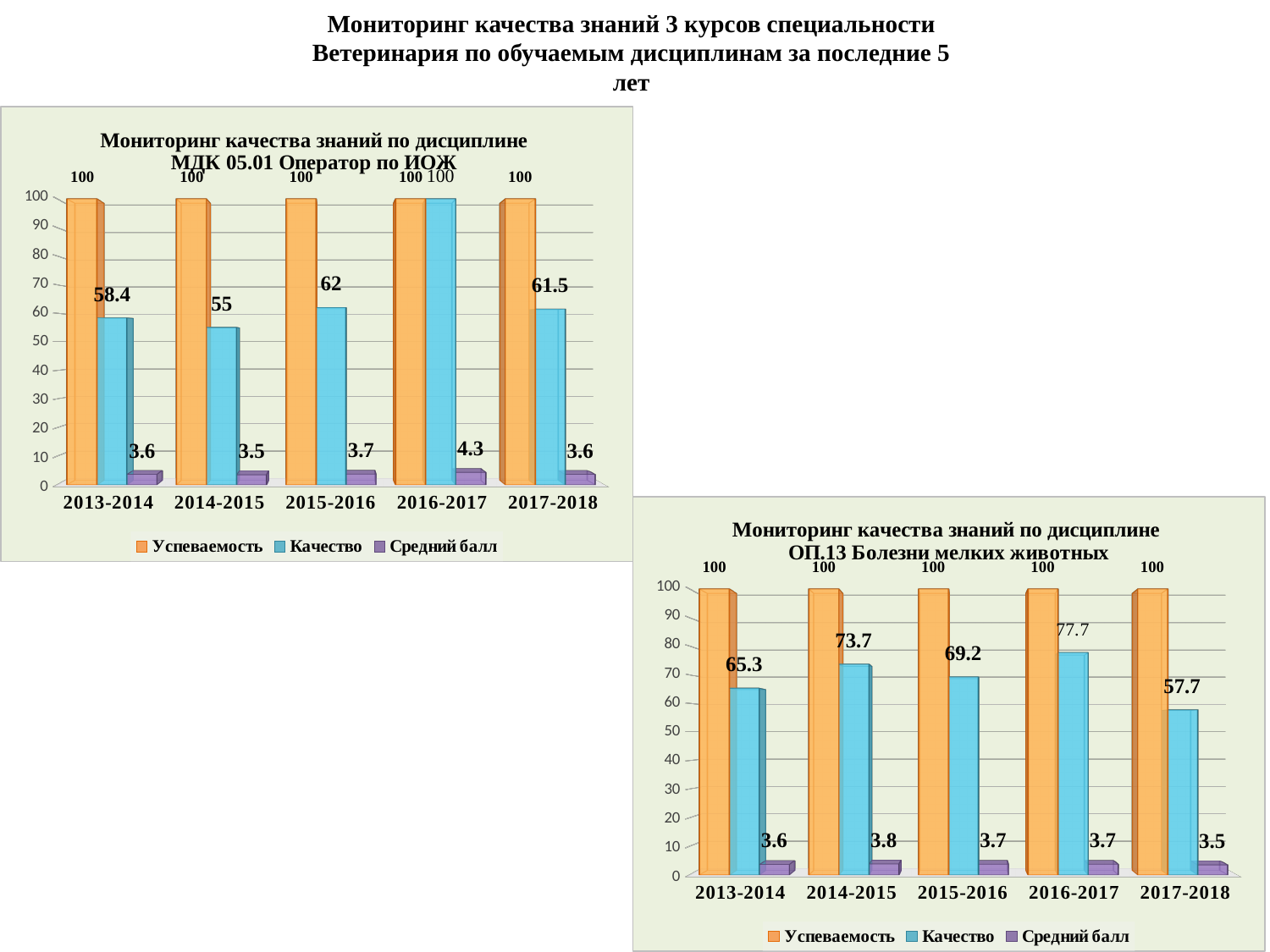
In the chart titled "Мониторинг качества знаний по дисциплине МДК 05.01 Оператор по ИОЖ", what is the value of Средний балл for 2016-2017? 4.3 In the chart titled "Мониторинг качества знаний по дисциплине ОП.13 Болезни мелких животных", which year has the lowest Средний балл? 2017-2018 What type of chart is the chart titled "Мониторинг качества знаний по дисциплине ОП.13 Болезни мелких животных"? bar chart In the chart titled "Мониторинг качества знаний по дисциплине МДК 05.01 Оператор по ИОЖ", what is the value of Качество for 2015-2016? 62 In the chart titled "Мониторинг качества знаний по дисциплине МДК 05.01 Оператор по ИОЖ", which year has the lowest Качество value? 2014-2015 In the chart titled "Мониторинг качества знаний по дисциплине ОП.13 Болезни мелких животных", which year has the highest Качество value? 2016-2017 In the chart titled "Мониторинг качества знаний по дисциплине МДК 05.01 Оператор по ИОЖ", what is the difference between the Качество values for 2017-2018 and 2013-2014? 3.1 In the chart titled "Мониторинг качества знаний по дисциплине ОП.13 Болезни мелких животных", how many academic years are shown on the x axis? 5 In the chart titled "Мониторинг качества знаний по дисциплине ОП.13 Болезни мелких животных", what is the value of Качество for 2014-2015? 73.7 In the chart titled "Мониторинг качества знаний по дисциплине ОП.13 Болезни мелких животных", what is the difference between the Качество values for 2016-2017 and 2017-2018? 20 In the chart titled "Мониторинг качества знаний по дисциплине ОП.13 Болезни мелких животных", is the Качество value for 2013-2014 larger or smaller than for 2015-2016? smaller In the chart titled "Мониторинг качества знаний по дисциплине МДК 05.01 Оператор по ИОЖ", how many series does the legend list? 3